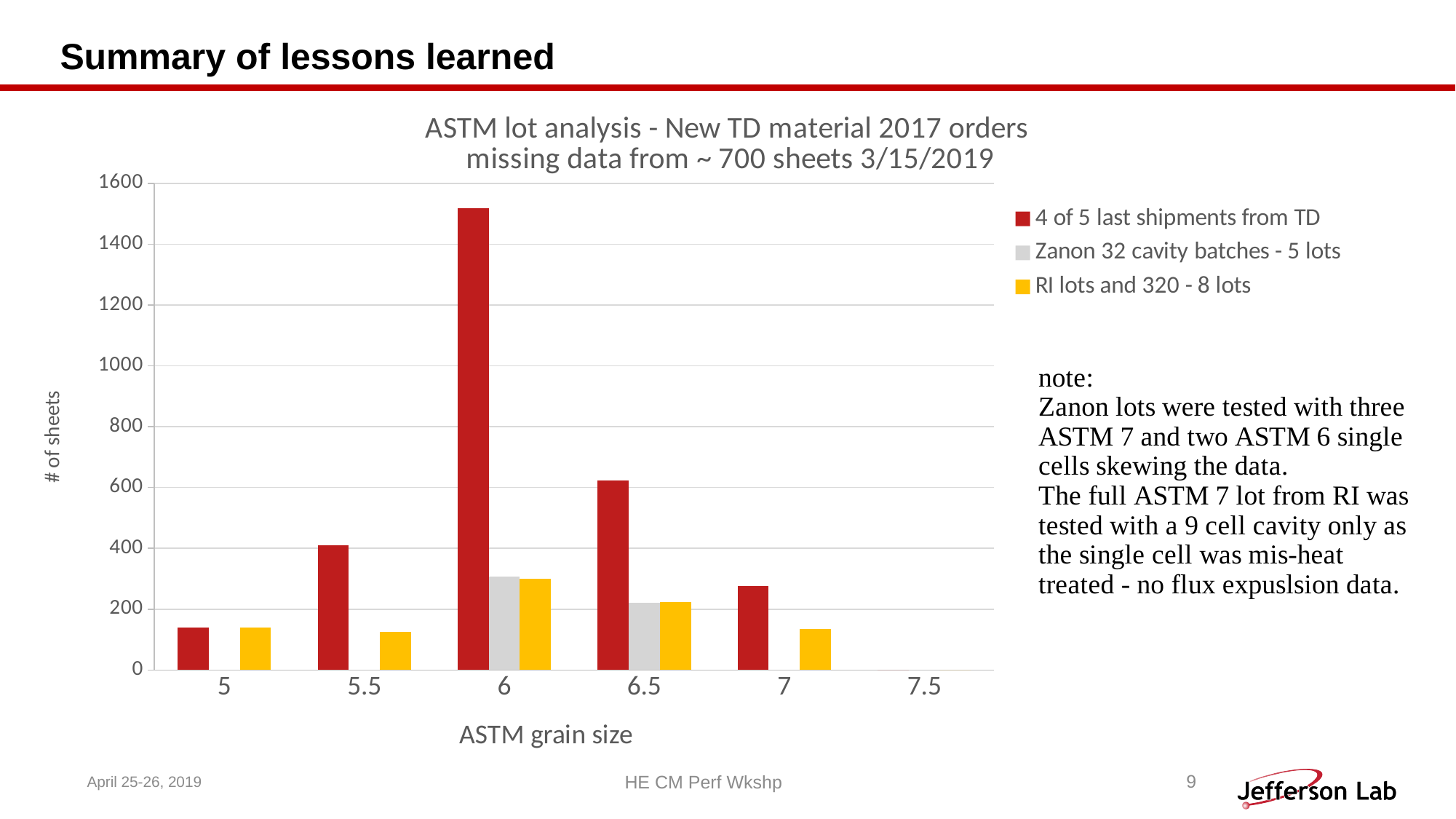
Is the value for '4 of 5 last shipments from TD' at grain size 6 greater or less than 1400? greater Is the value for '4 of 5 last shipments from TD' at grain size 6.5 greater or less than 800? less At which ASTM grain size is the bar for '4 of 5 last shipments from TD' highest? 6 Is the value for 'RI lots and 320 - 8 lots' at grain size 7 greater or less than 200? less For 'Zanon 32 cavity batches - 5 lots', which is larger: the value at grain size 6 or at grain size 6.5? 6 What kind of chart is shown on the slide? bar chart How many ASTM grain size categories are shown on the x axis? 6 How many series does the legend list? 3 What is the label of the y axis? # of sheets Which colour represents the 'RI lots and 320 - 8 lots' series? yellow For '4 of 5 last shipments from TD', which is larger: the value at grain size 5.5 or at grain size 6.5? 6.5